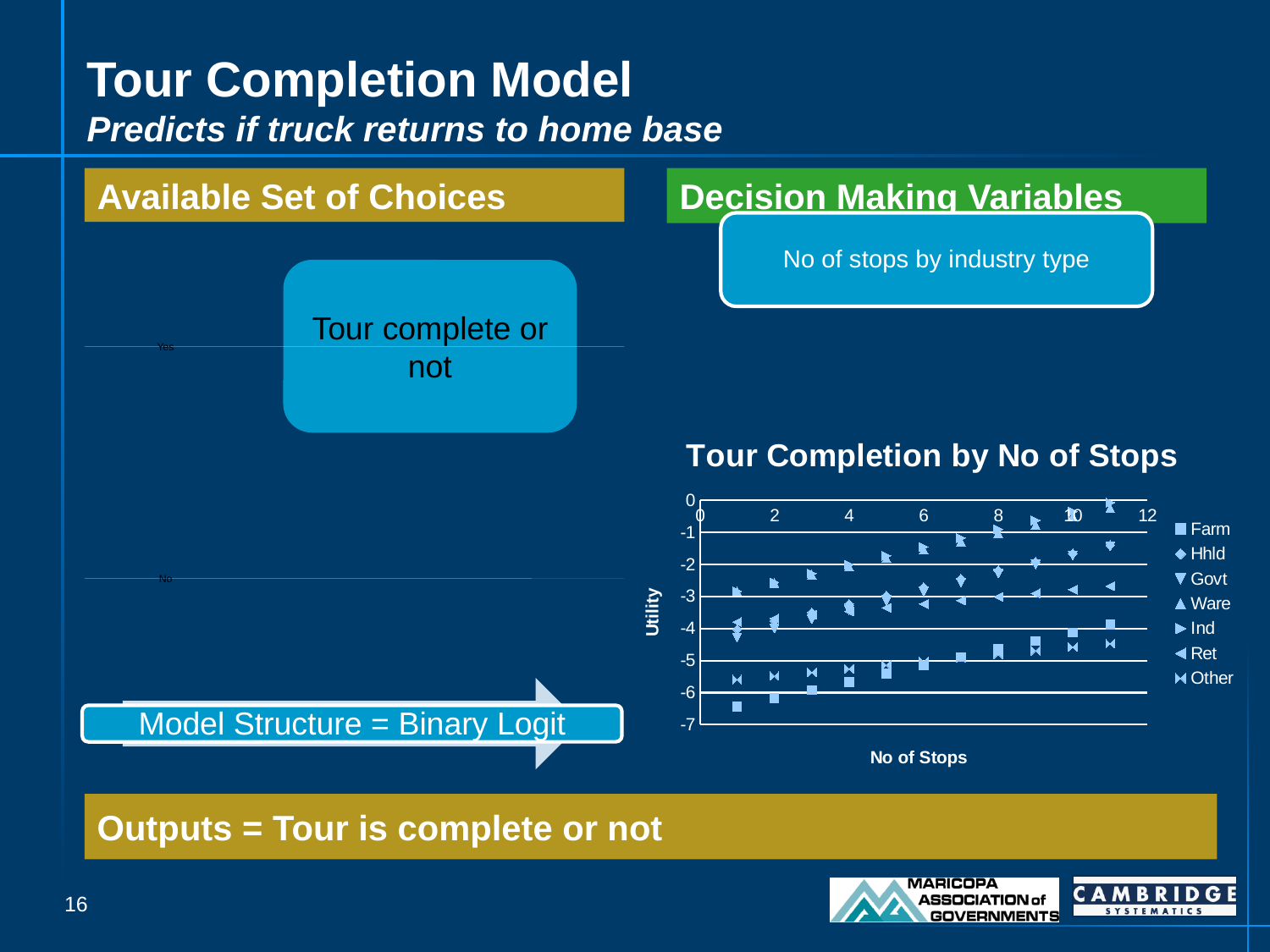
In the "Tour Completion by No of Stops" chart, does the utility for Farm rise or fall as the number of stops increases? rise In the "Tour Completion by No of Stops" chart, is the Other utility at 1 stop greater or less than -6? greater In the "Tour Completion by No of Stops" chart, which series has the lowest utility at 1 stop? Farm In the "Tour Completion by No of Stops" chart, is the Farm utility at 11 stops greater or less than -5? greater In the "Tour Completion by No of Stops" chart, at 11 stops, which has the higher utility, Ware or Farm? Ware What is the label of the vertical axis in the "Tour Completion by No of Stops" chart? Utility In the "Tour Completion by No of Stops" chart, is the Ware utility at 11 stops greater or less than -1? greater In the "Tour Completion by No of Stops" chart, does the utility for Ware rise or fall as the number of stops increases? rise How many series does the legend of the "Tour Completion by No of Stops" chart list? 7 What is the title of the chart on the right side of the slide? Tour Completion by No of Stops What kind of chart is "Tour Completion by No of Stops"? scatter chart